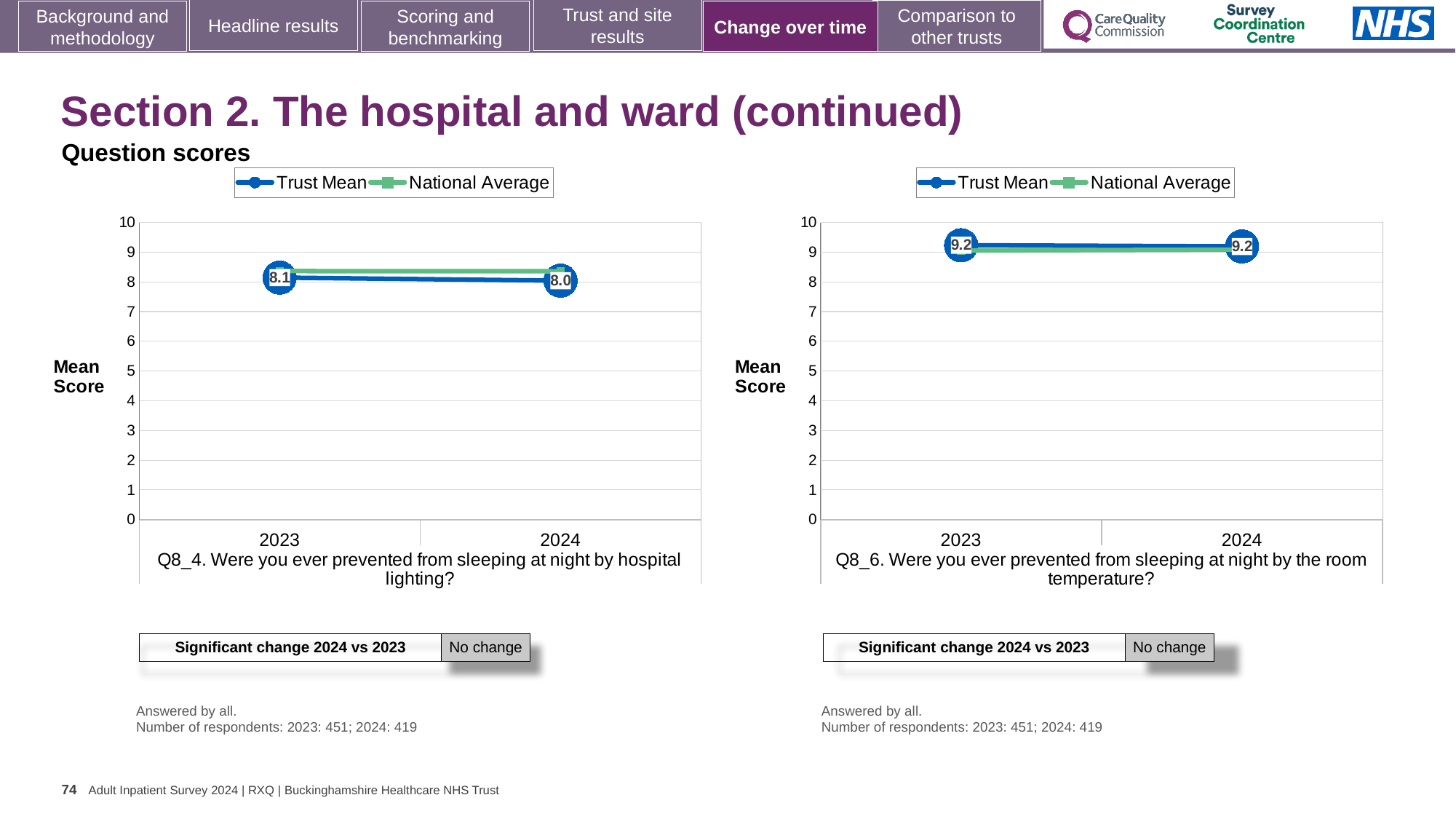
How many years are plotted on the x axis of the Q8_4 hospital lighting chart? 2 In the Q8_4 hospital lighting chart, is the National Average for 2023 greater or less than 8? greater What kind of chart is the Q8_4 hospital lighting chart? line chart In the Q8_4 hospital lighting chart, what is the difference between the Trust Mean for 2023 and 2024? 0.1 In the Q8_6 room temperature chart, does the Trust Mean rise, fall or stay the same from 2023 to 2024? stay the same In the Q8_4 hospital lighting chart, which is larger for 2023: the Trust Mean or the National Average? National Average How many series does the legend of the Q8_6 room temperature chart list? 2 In the Q8_4 hospital lighting chart, does the Trust Mean rise or fall from 2023 to 2024? fall In the Q8_6 room temperature chart, what is the Trust Mean for 2023? 9.2 In the Q8_4 hospital lighting chart, what is the Trust Mean for 2023? 8.1 In the Q8_6 room temperature chart, what is the Trust Mean for 2024? 9.2 In the Q8_4 hospital lighting chart, what is the Trust Mean for 2024? 8.0